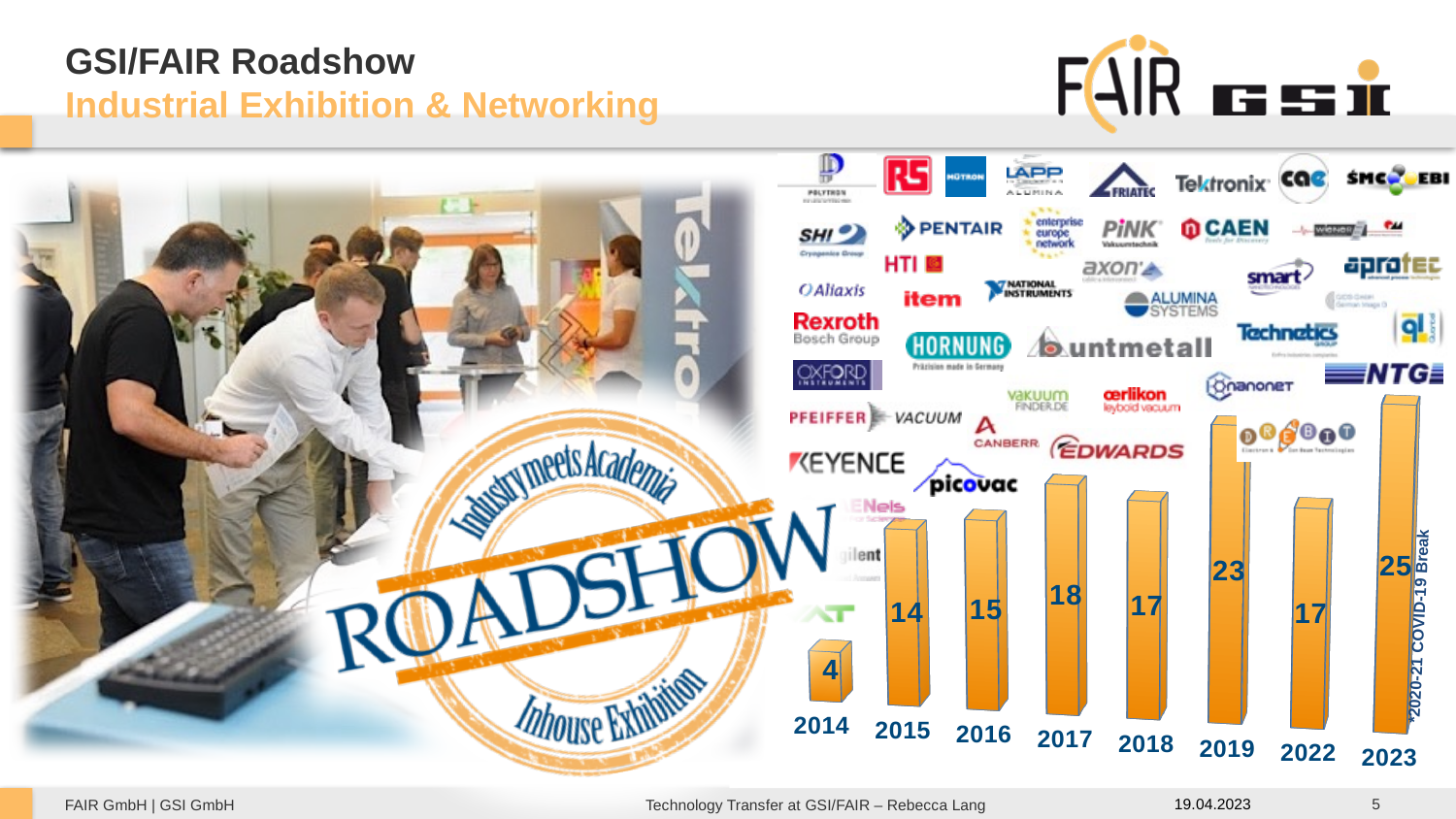
What kind of chart is shown on the slide? bar chart How many years are shown on the x axis of the chart? 8 What is the value shown for 2019? 23 Which year has the lowest value? 2014 What is the difference between the values for 2023 and 2019? 2 What is the value shown for 2014? 4 What label is written next to the gap between 2019 and 2022 in the chart? 2020-21 COVID-19 Break What is the value shown for 2017? 18 What is the value shown for 2022? 17 Which is larger, the value for 2017 or the value for 2018? 2017 Which year has the highest value? 2023 What is the difference between the values for 2015 and 2014? 10